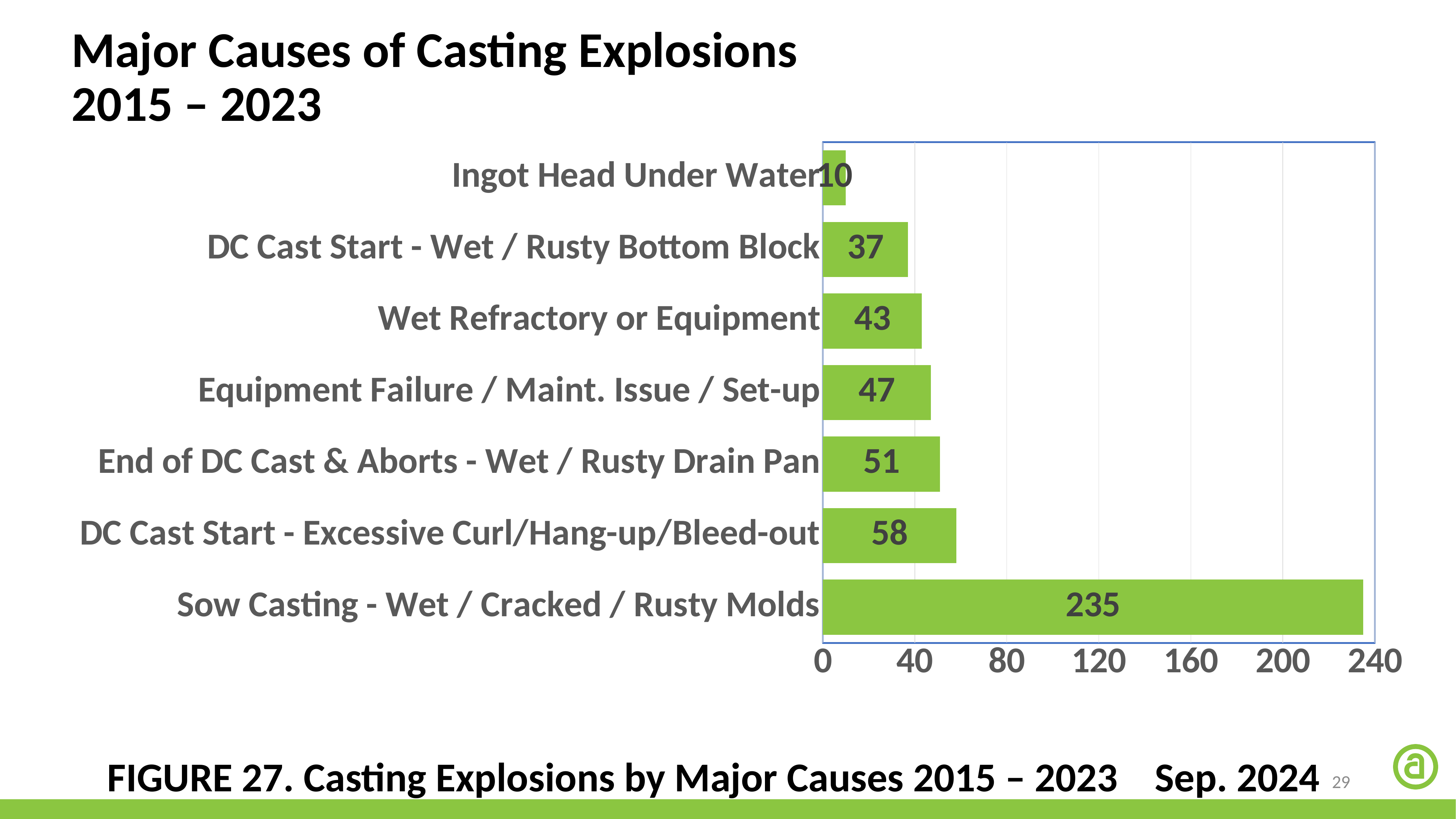
Which cause has the lowest number of casting explosions? Ingot Head Under Water What is the value for Sow Casting - Wet / Cracked / Rusty Molds? 235 Which cause has the highest number of casting explosions? Sow Casting - Wet / Cracked / Rusty Molds What is the value for Wet Refractory or Equipment? 43 What kind of chart is shown on the slide? bar chart How many causes are shown in the chart? 7 What is the difference between the values for Sow Casting - Wet / Cracked / Rusty Molds and DC Cast Start - Excessive Curl/Hang-up/Bleed-out? 177 Which is larger, the value for DC Cast Start - Excessive Curl/Hang-up/Bleed-out or the value for Ingot Head Under Water? DC Cast Start - Excessive Curl/Hang-up/Bleed-out Is the value for Sow Casting - Wet / Cracked / Rusty Molds greater or less than 200? greater What is the value for End of DC Cast & Aborts - Wet / Rusty Drain Pan? 51 What is the difference between the values for Equipment Failure / Maint. Issue / Set-up and Wet Refractory or Equipment? 4 What is the value for DC Cast Start - Wet / Rusty Bottom Block? 37